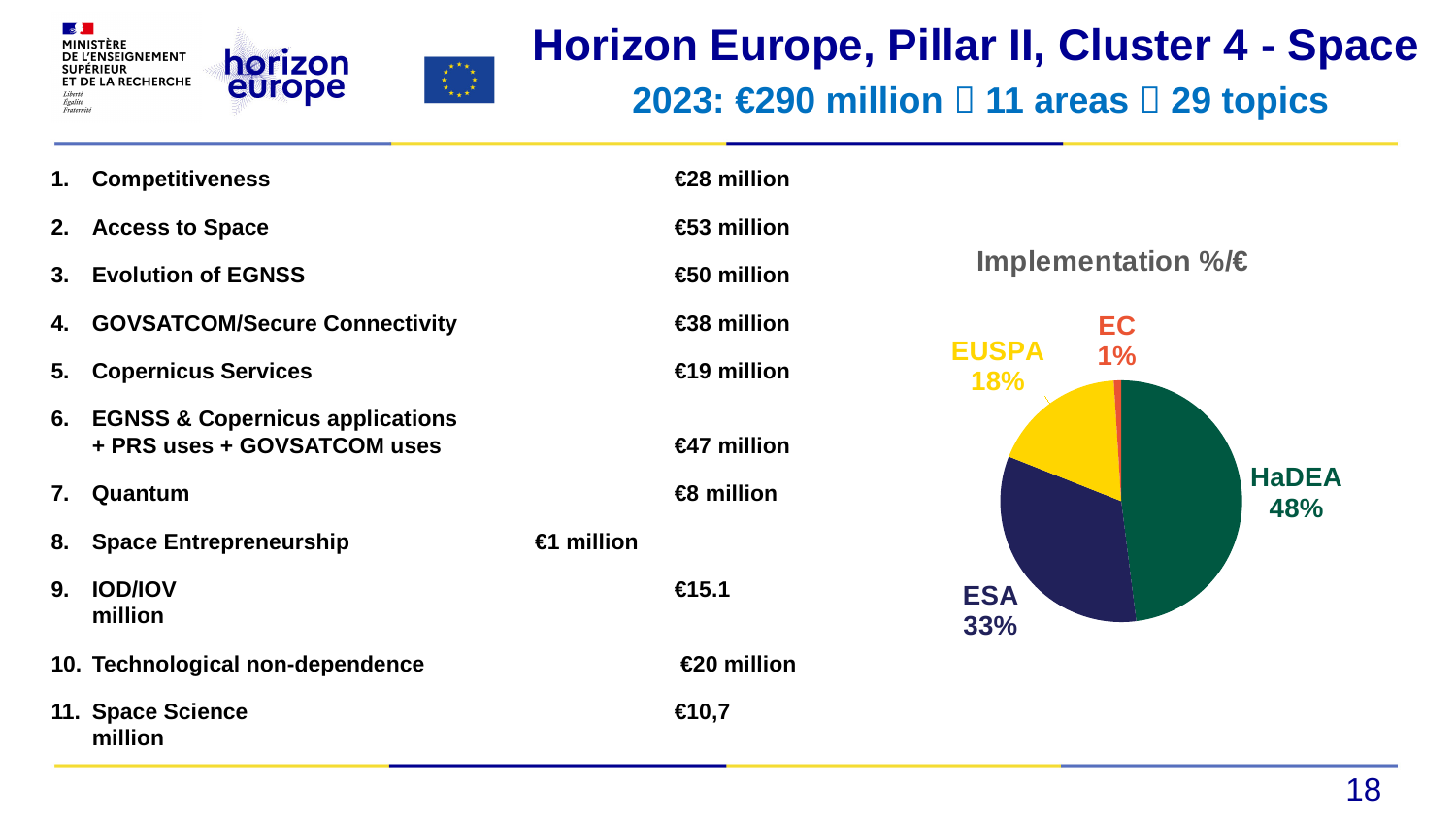
How many slices does the pie chart have? 4 What is the difference in percentage points between the HaDEA and ESA slices? 15 Which slice of the pie is the largest? HaDEA Which is larger, the ESA slice or the EUSPA slice? ESA What share of the pie does ESA have? 33% What colour is the HaDEA slice of the pie? green Which slice of the pie is the smallest? EC What share of the pie does EUSPA have? 18% What kind of chart is shown on the slide? pie chart What is the title of the chart? Implementation %/€ What share of the pie does EC have? 1%